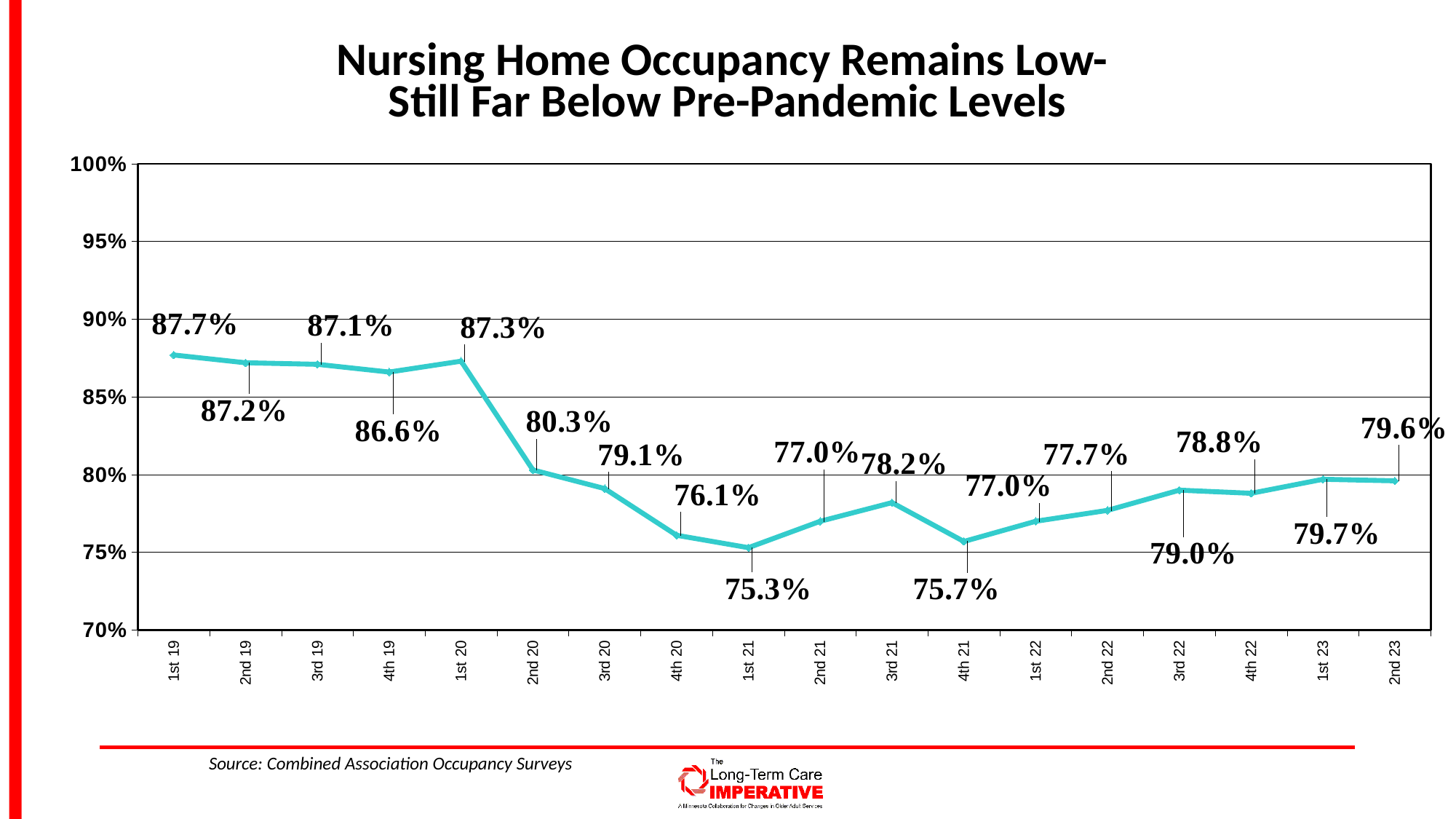
What is the title of the chart? Nursing Home Occupancy Remains Low- Still Far Below Pre-Pandemic Levels What kind of chart is shown on the slide? Line chart Which quarter has the lowest occupancy rate? 1st 21 Is the occupancy rate for 4th 20 greater or less than 80%? less What is the occupancy rate for 2nd 20? 80.3% Which is higher, the occupancy rate in 3rd 21 or 4th 21? 3rd 21 What is the nursing home occupancy rate for 1st 19? 87.7% Which quarter has the highest occupancy rate? 1st 19 How many quarters are plotted on the chart? 18 What is the occupancy rate for 2nd 23? 79.6% Does the occupancy rate rise or fall between 1st 20 and 1st 21? Fall What is the difference between the occupancy rate in 1st 20 and 2nd 20? 7.0%